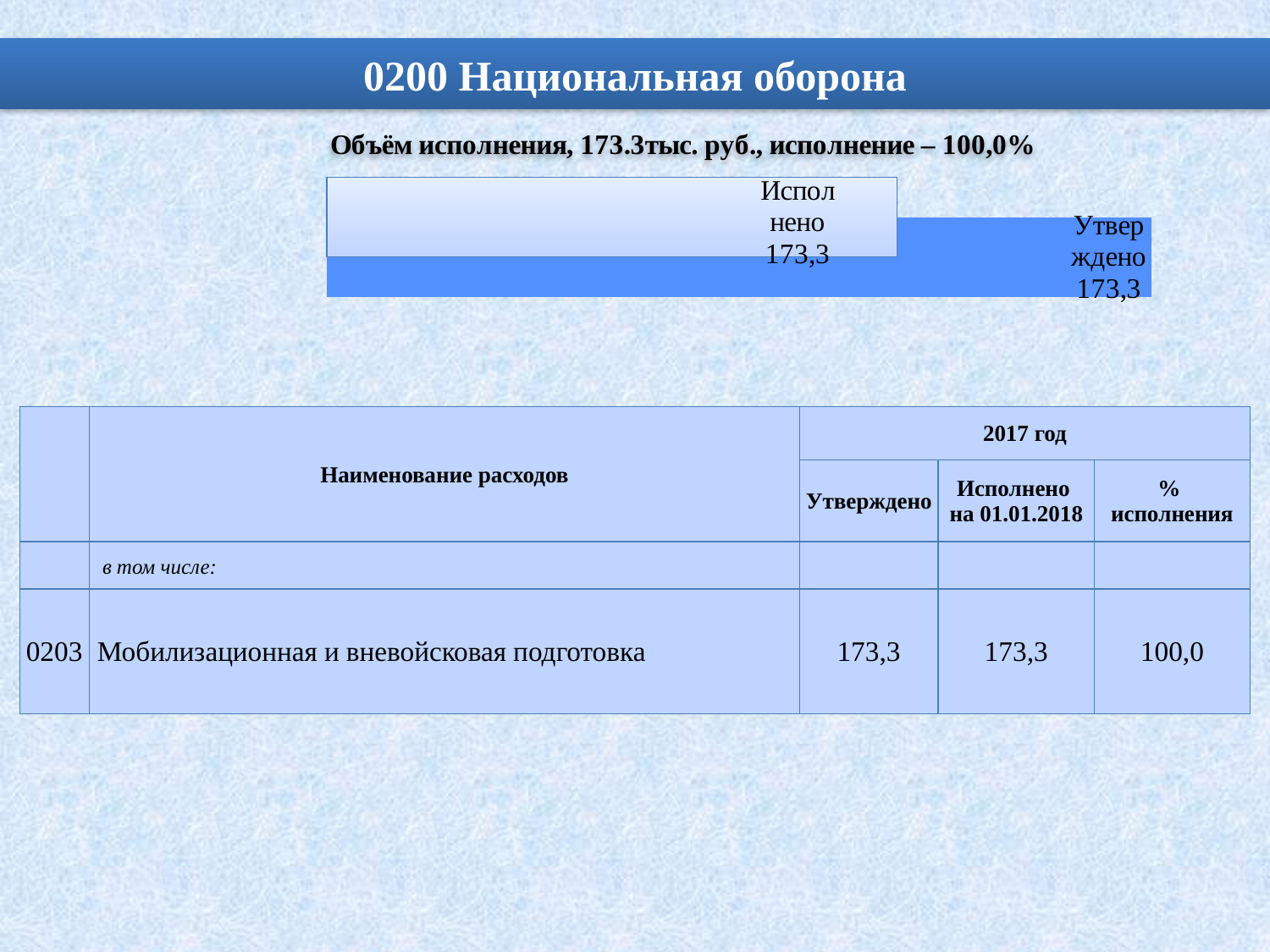
Which two categories are labelled on the bars of the chart? Исполнено and Утверждено What is the difference between the Утверждено and Исполнено values in the chart? 0,0 What kind of chart is shown on the slide? bar chart Are the bars in the chart horizontal or vertical? horizontal How many bars are plotted in the chart? 2 What is the value shown for Утверждено in the chart? 173,3 What is the value shown for Исполнено in the chart? 173,3